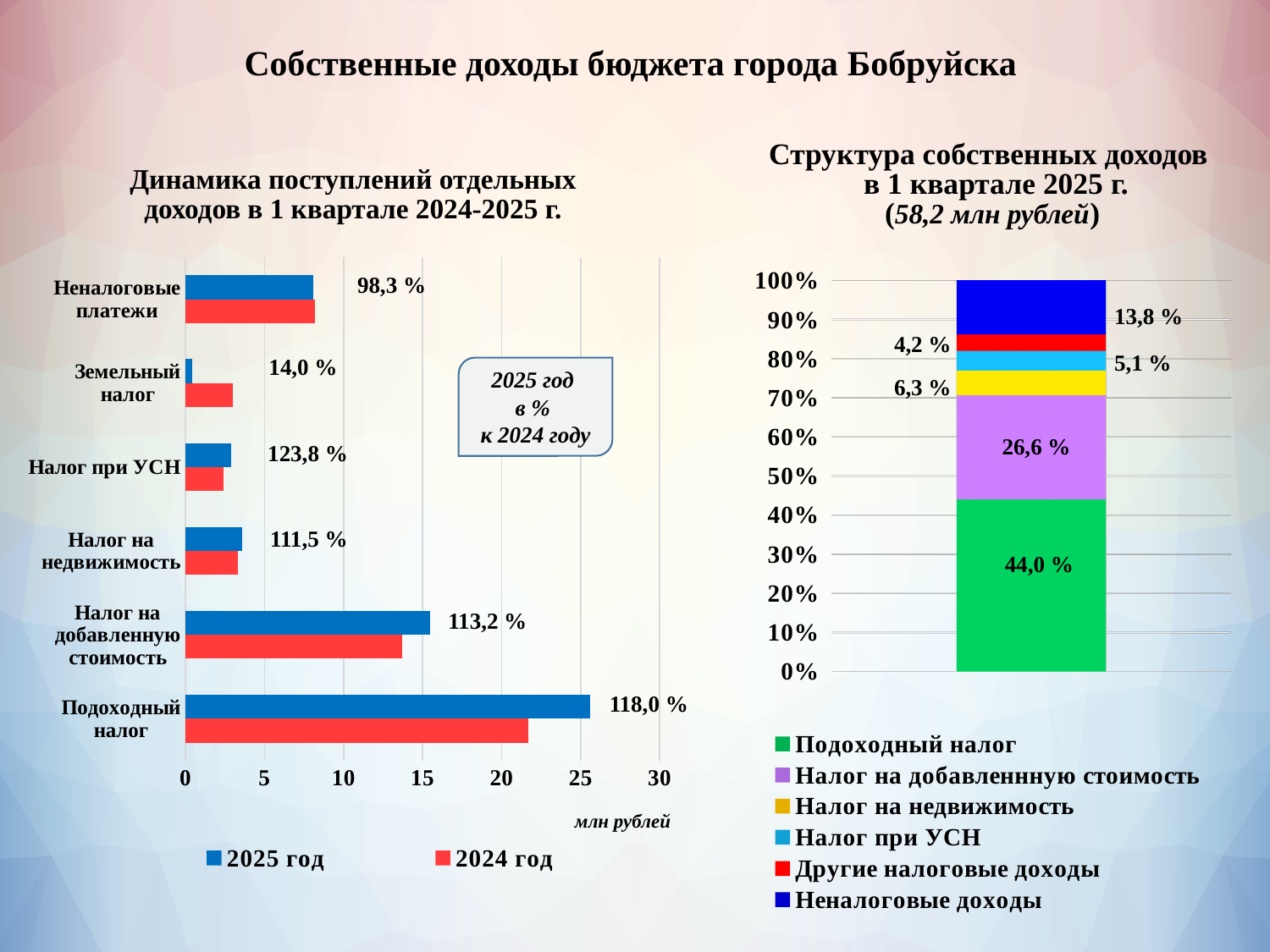
On the left chart (Динамика поступлений отдельных доходов), how many series does the legend list? 2 On the left chart (Динамика поступлений отдельных доходов), which category has the lowest percentage label? Земельный налог On the left chart (Динамика поступлений отдельных доходов), what percentage label is shown for Земельный налог? 14,0 % On the left chart (Динамика поступлений отдельных доходов), what percentage label is shown for Подоходный налог? 118,0 % On the right chart (Структура собственных доходов в 1 квартале 2025 г.), what is the difference between the shares of Подоходный налог and Налог на добавленную стоимость? 17,4 % What kind of chart is the left chart (Динамика поступлений отдельных доходов)? bar chart On the left chart (Динамика поступлений отдельных доходов), which is larger for Подоходный налог: the 2025 год bar or the 2024 год bar? 2025 год On the left chart (Динамика поступлений отдельных доходов), is the 2025 год value for Налог на добавленную стоимость greater or less than 10? greater On the left chart (Динамика поступлений отдельных доходов), which category has the highest percentage label? Налог при УСН On the right chart (Структура собственных доходов в 1 квартале 2025 г.), how many entries does the legend list? 6 On the right chart (Структура собственных доходов в 1 квартале 2025 г.), what share does Подоходный налог have? 44,0 % On the left chart (Динамика поступлений отдельных доходов), how many categories are shown? 6